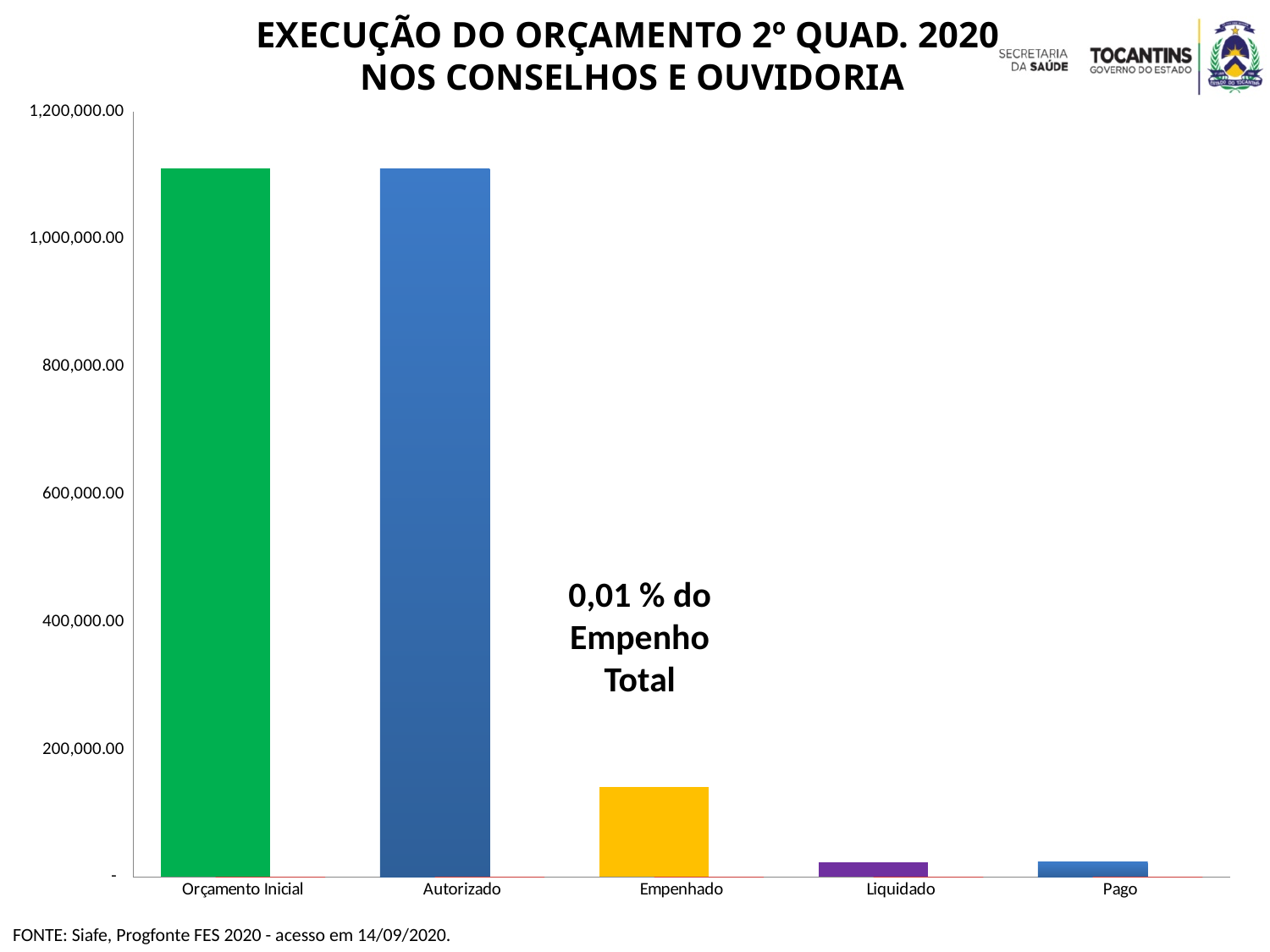
What is the title of the chart? EXECUÇÃO DO ORÇAMENTO 2º QUAD. 2020 NOS CONSELHOS E OUVIDORIA Which is larger, the value for Autorizado or the value for Empenhado? Autorizado Which is larger, the value for Empenhado or the value for Liquidado? Empenhado What text annotation is printed above the Empenhado bar? 0,01 % do Empenho Total Is the value for Pago greater or less than 200,000.00? less Is the value for Liquidado greater or less than 200,000.00? less Is the value for Empenhado greater or less than 200,000.00? less How many categories are shown on the x axis of the chart? 5 What kind of chart is shown on the slide? bar chart Do the values generally rise or fall from left to right along the x axis? fall